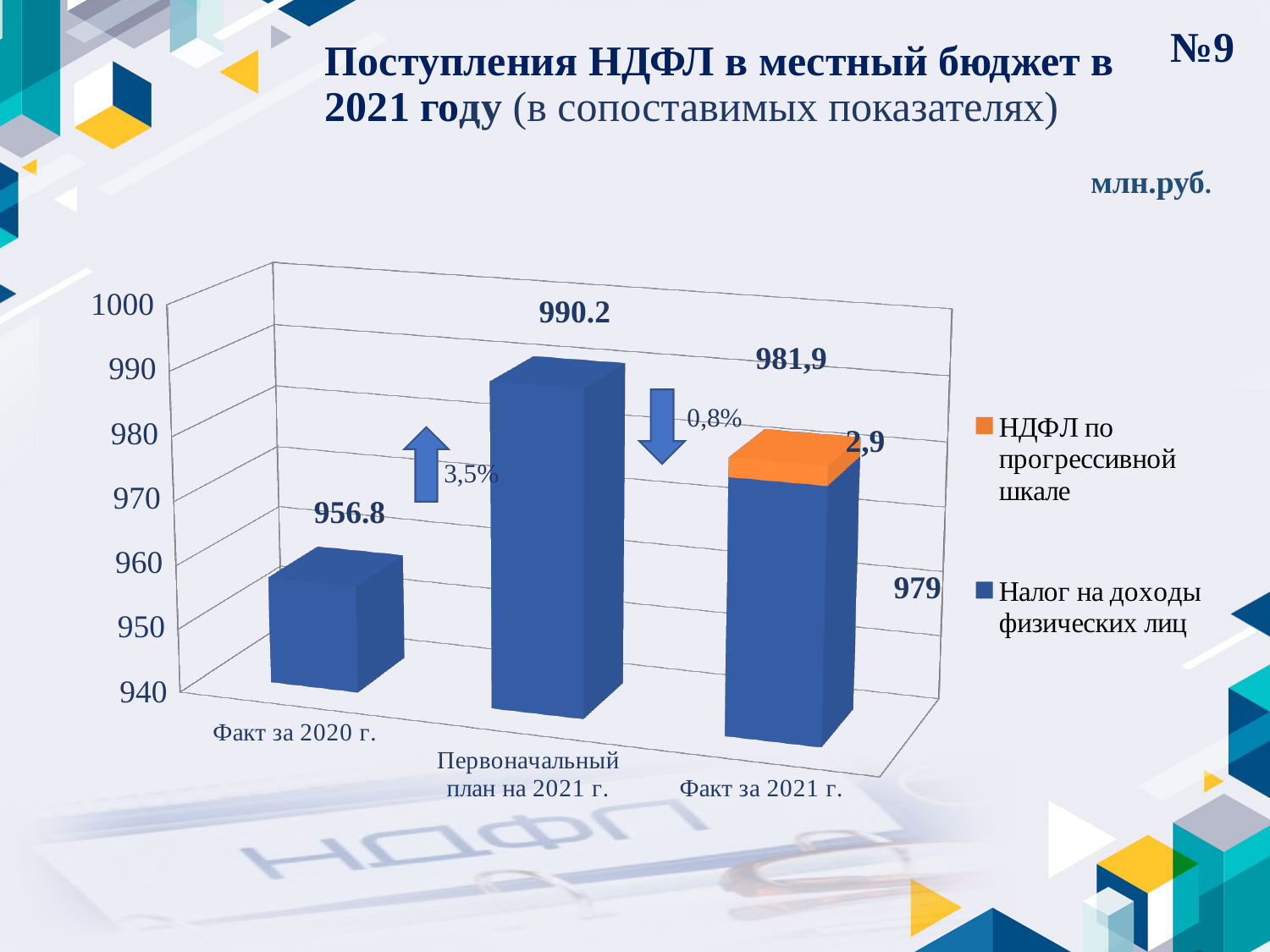
Is the value for "Факт за 2020 г." greater or less than 960? less What is the total labelled above the stacked bar for "Факт за 2021 г."? 981,9 Which category has the lowest bar? Факт за 2020 г. What is the value labelled for "Первоначальный план на 2021 г."? 990.2 What is the value of the "НДФЛ по прогрессивной шкале" series for "Факт за 2021 г."? 2,9 How many categories are shown on the x axis? 3 What is the value of the "Налог на доходы физических лиц" series for "Факт за 2021 г."? 979 What unit of measurement is stated for the chart? млн.руб. What is the value labelled for "Факт за 2020 г."? 956.8 Which category has the highest bar? Первоначальный план на 2021 г. Which is larger: the value for "Факт за 2020 г." or the value for "Первоначальный план на 2021 г."? Первоначальный план на 2021 г. How many series does the legend list? 2